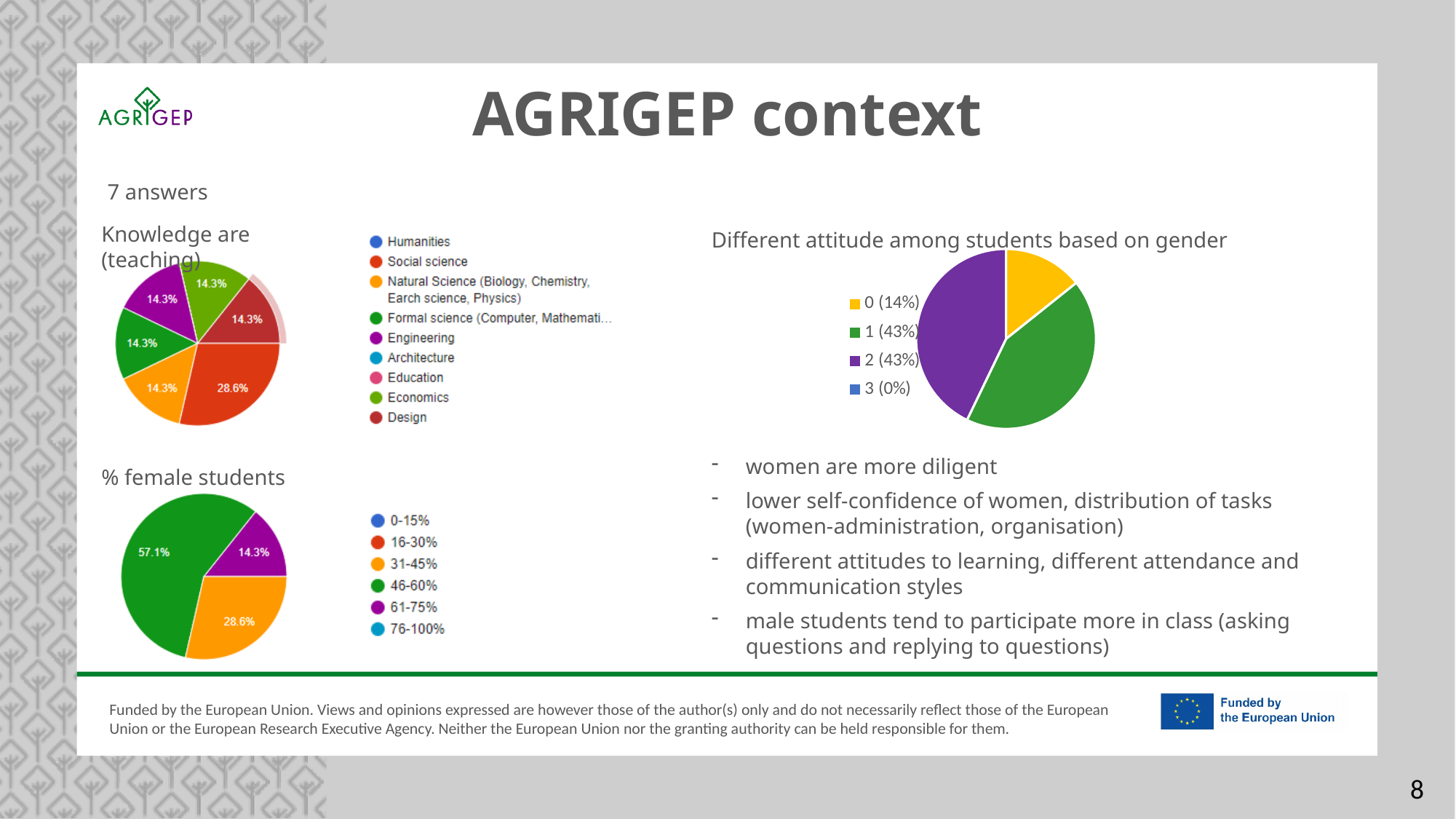
In the 'Different attitude among students based on gender' chart, what percentage is shown for category 0? 14% In the '% female students' pie chart, what share does the 31-45% category have? 28.6% In the '% female students' pie chart, what share does the 46-60% category have? 57.1% In the 'Knowledge are (teaching)' pie chart, how many categories does the legend list? 9 In the 'Knowledge are (teaching)' pie chart, which category has the largest slice? Social science In the 'Different attitude among students based on gender' chart, what percentage is shown for category 3? 0% In the 'Knowledge are (teaching)' pie chart, what is the difference between the Social science share and the Engineering share? 14.3% In the 'Knowledge are (teaching)' pie chart, what share does Social science have? 28.6% What type of chart is used for 'Different attitude among students based on gender'? Pie chart In the '% female students' pie chart, which category has the largest slice? 46-60% In the '% female students' pie chart, how many categories does the legend list? 6 In the '% female students' pie chart, which category has the smallest slice? 61-75%